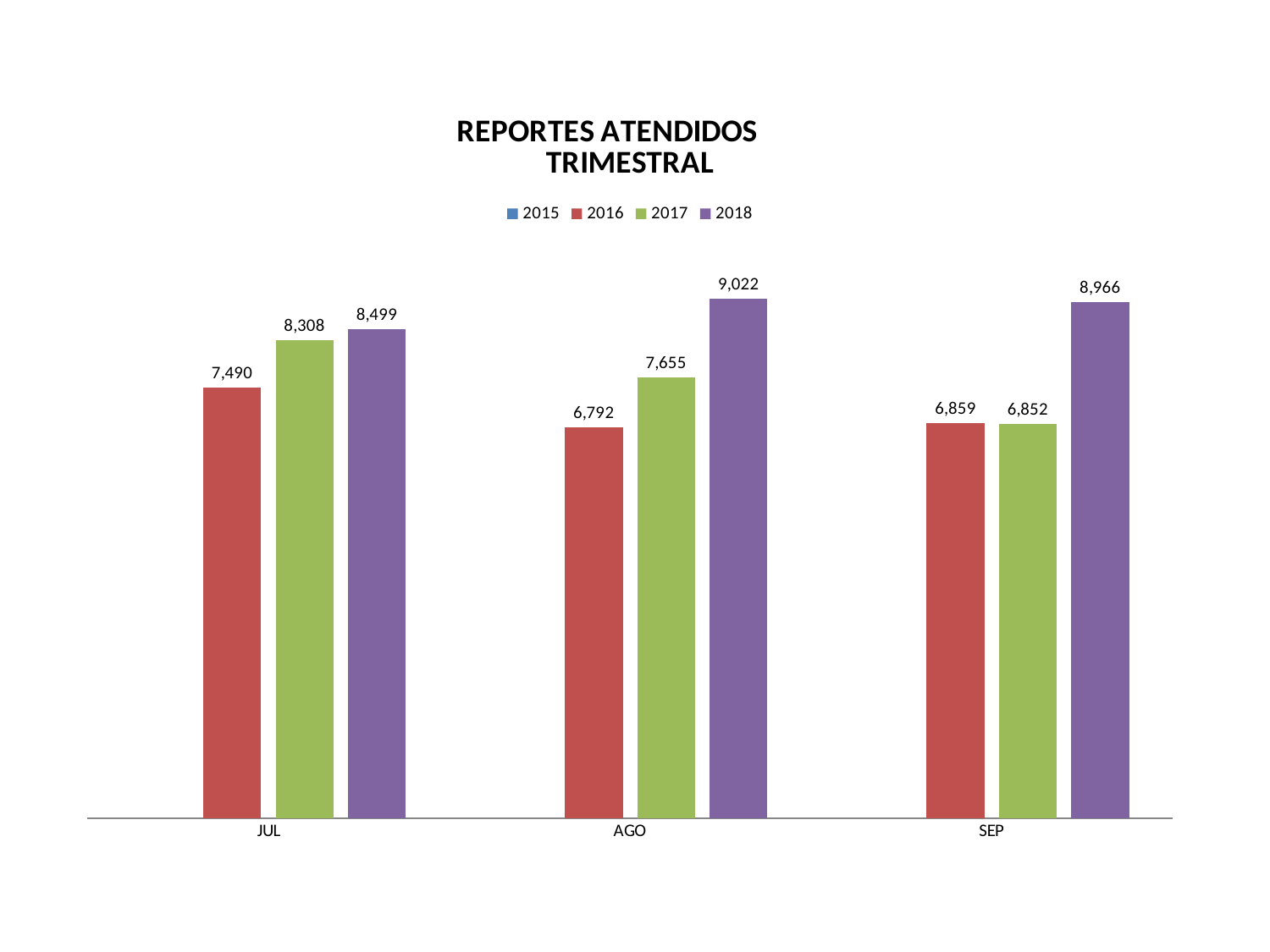
Which month has the lowest value for 2016? AGO How many series does the legend list? 4 Which month has the highest value for 2018? AGO What is the title of the chart? REPORTES ATENDIDOS TRIMESTRAL Which is larger, the 2017 value in JUL or the 2017 value in AGO? JUL What is the difference between the 2018 and 2016 values in SEP? 2,107 What kind of chart is shown? Bar chart How many months are shown on the x axis? 3 What is the difference between the 2017 values in JUL and AGO? 653 What is the value for 2016 in JUL? 7,490 What is the value for 2017 in SEP? 6,852 What is the value for 2018 in AGO? 9,022